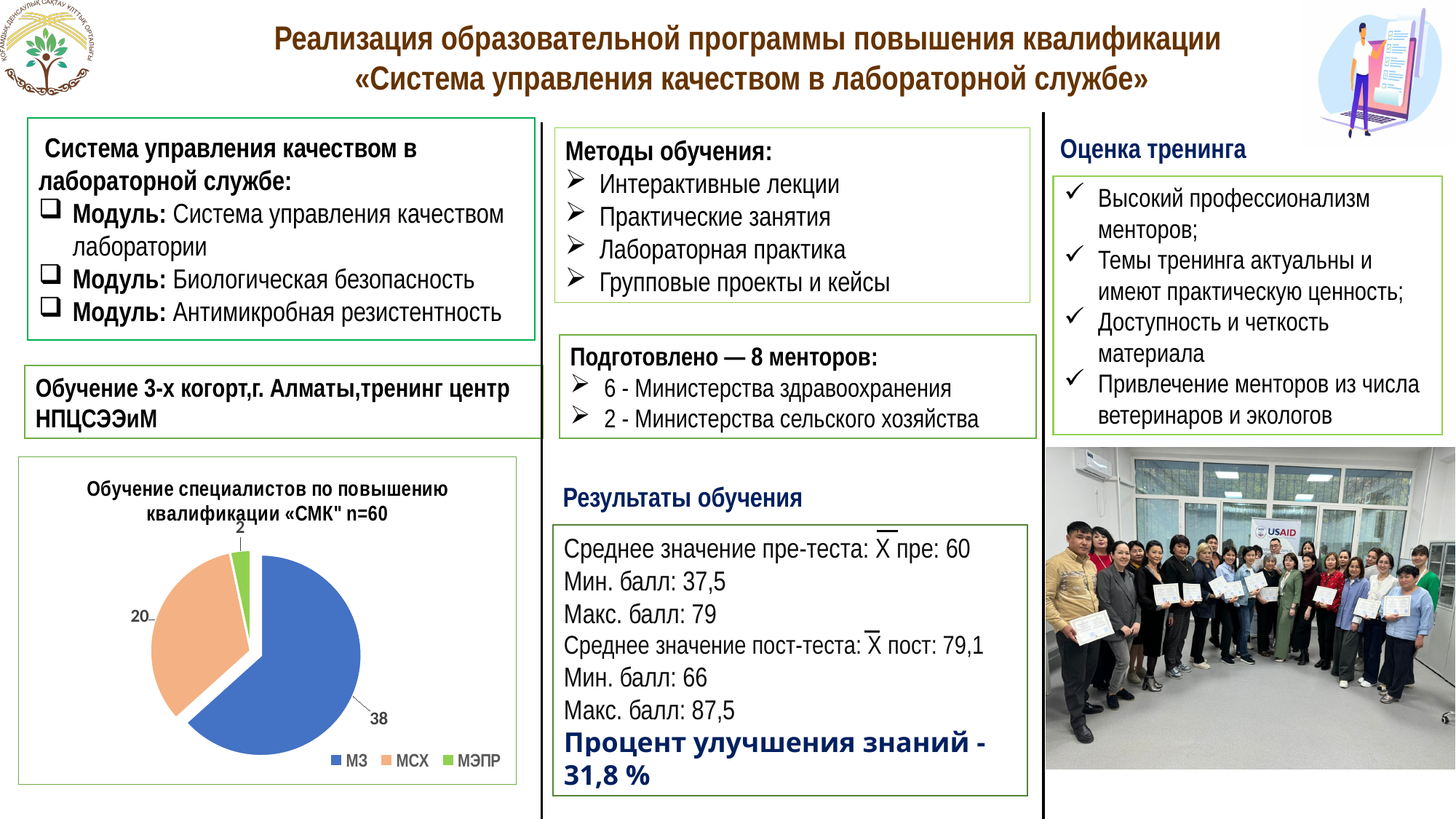
What is the value for МСХ in the pie chart? 20 What colour is the МСХ slice in the pie chart? orange What kind of chart is shown on the slide? pie chart What is the value for МЭПР in the pie chart? 2 What share of the pie does МЭПР represent? 3.3% Which category has the largest slice in the pie chart? МЗ Which is larger, the value for МСХ or the value for МЭПР? МСХ What is the total of all slices in the pie chart? 60 What is the difference between the values for МЗ and МСХ? 18 How many categories does the pie chart show? 3 Which category has the smallest slice in the pie chart? МЭПР What is the value for МЗ in the pie chart? 38